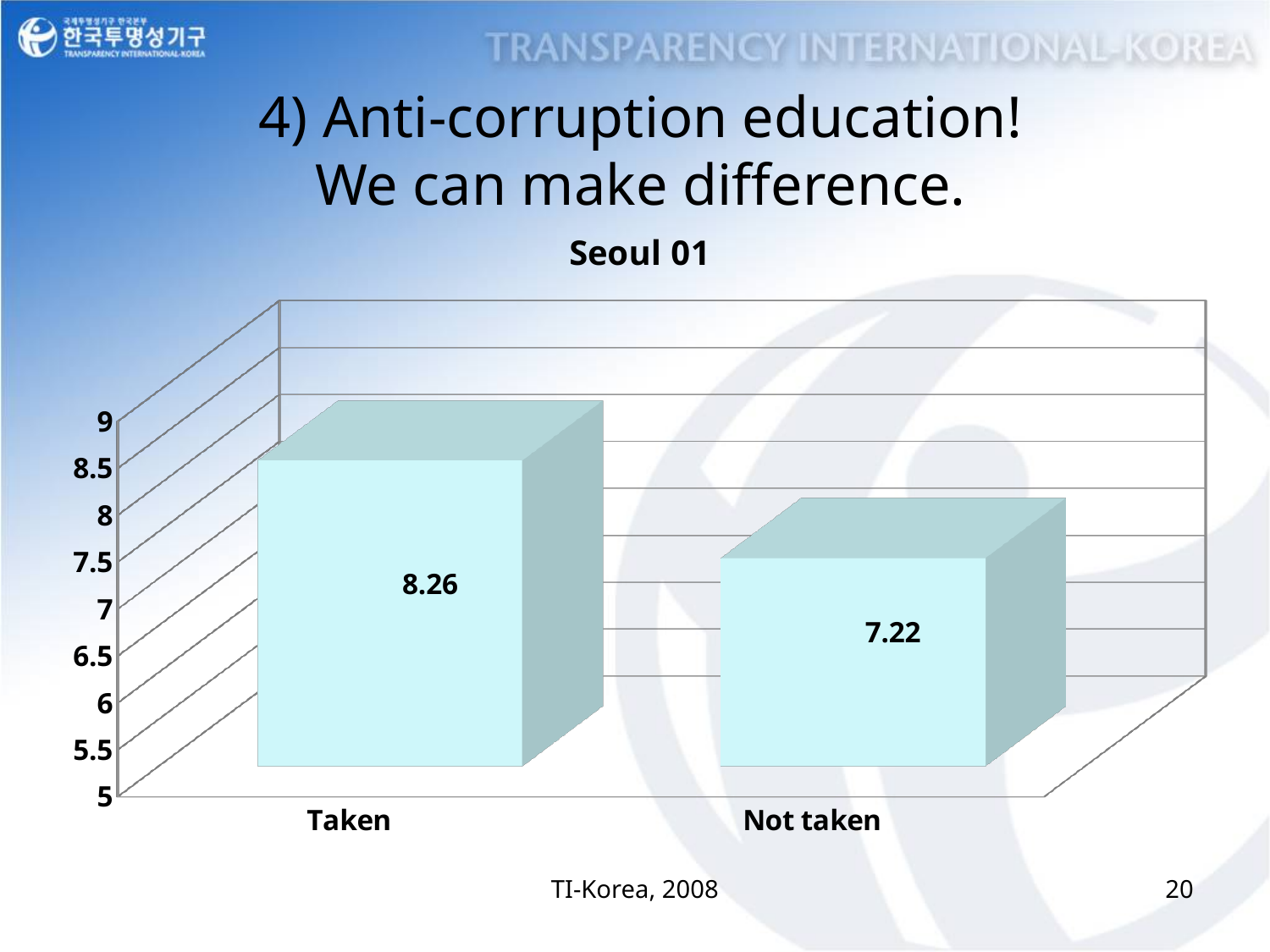
Which is larger, the value for Taken or the value for Not taken? Taken Which category has the highest value? Taken Which category has the lowest value? Not taken Is the value for Taken greater or less than 8? greater What kind of chart is shown on the slide? Bar chart What is the difference between the values for Taken and Not taken? 1.04 What is the title of the chart? Seoul 01 What is the lowest value shown on the vertical axis? 5 What is the value for Not taken? 7.22 How many categories are shown on the chart? 2 Is the value for Not taken greater or less than 7.5? less What is the value for Taken? 8.26